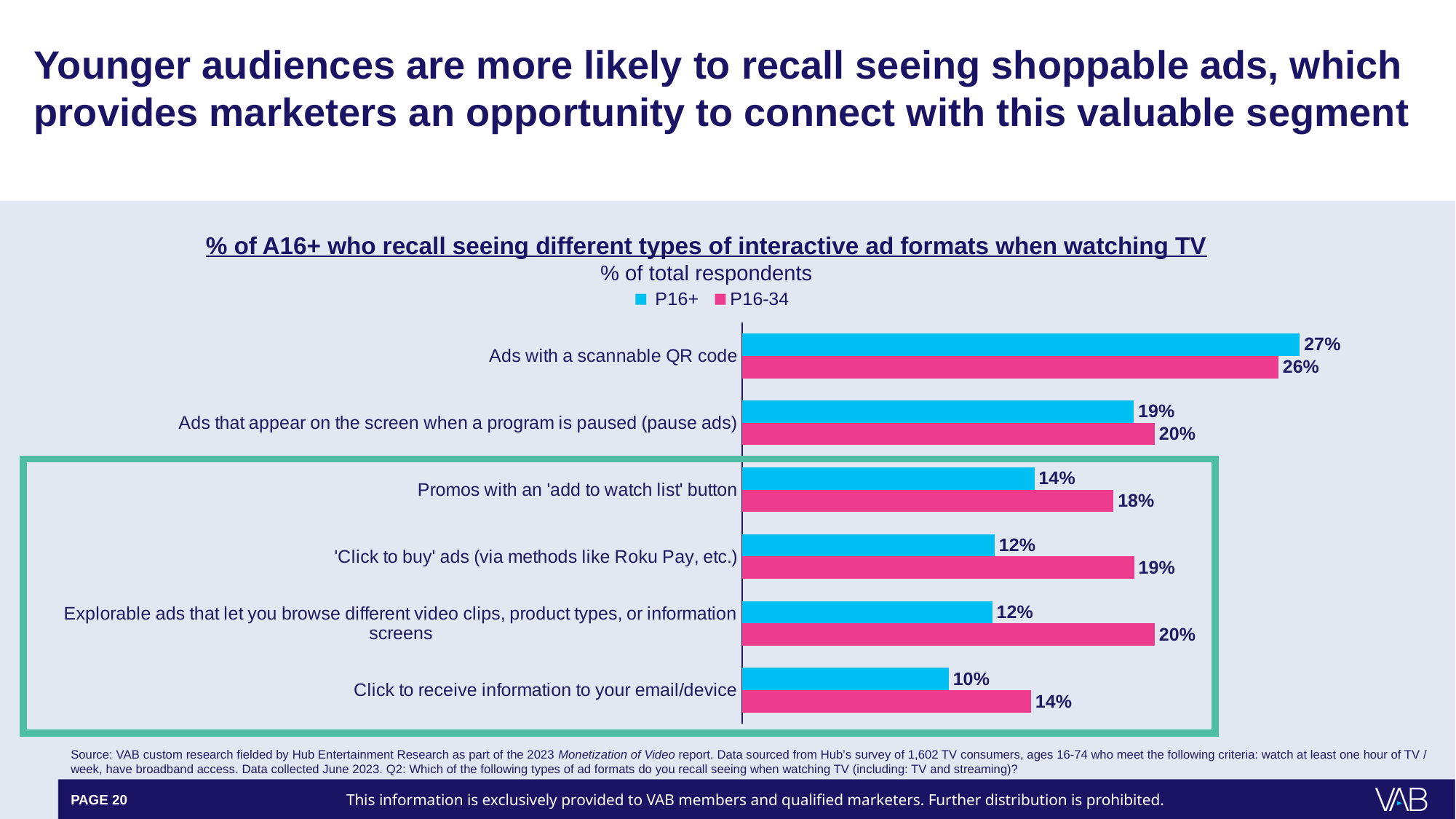
What percentage of P16-34 recall seeing 'Click to buy' ads (via methods like Roku Pay, etc.)? 19% What type of chart is shown on the slide? Bar chart How many ad format categories are shown in the chart? 6 Which ad format has the lowest recall among P16-34? Click to receive information to your email/device How many series does the legend list? 2 What is the difference between the P16-34 and P16+ values for 'Click to buy' ads? 7% What is the P16-34 value for 'Click to receive information to your email/device'? 14% For promos with an 'add to watch list' button, which group has the higher value, P16+ or P16-34? P16-34 What is the difference between the P16-34 and P16+ values for explorable ads that let you browse different video clips, product types, or information screens? 8% For ads with a scannable QR code, which group has the higher value, P16+ or P16-34? P16+ What percentage of P16+ recall seeing ads with a scannable QR code? 27% Which ad format has the highest recall among P16+? Ads with a scannable QR code